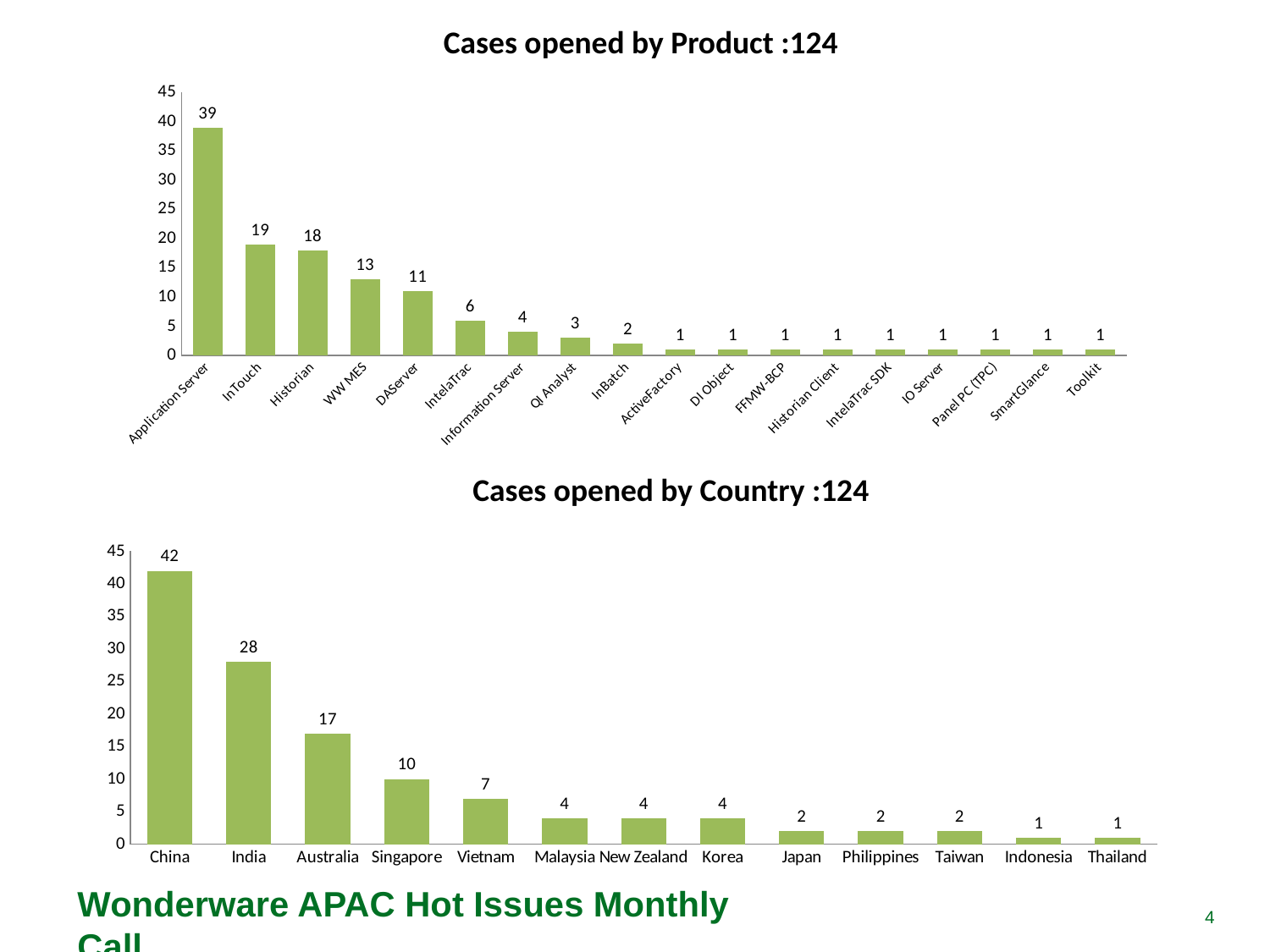
In the 'Cases opened by Country' chart, how many countries are shown? 13 What type of chart is the 'Cases opened by Country' chart? bar chart In the 'Cases opened by Product' chart, how many product categories are shown? 18 What is the title of the top chart on the slide? Cases opened by Product :124 In the 'Cases opened by Product' chart, which has more cases, WW MES or DAServer? WW MES In the 'Cases opened by Product' chart, what is the difference between the cases for Application Server and Historian? 21 In the 'Cases opened by Country' chart, do the values rise or fall from left to right along the x axis? fall In the 'Cases opened by Country' chart, what is the difference between the cases for China and India? 14 In the 'Cases opened by Country' chart, how many cases were opened for Singapore? 10 In the 'Cases opened by Product' chart, which product has the highest number of cases? Application Server In the 'Cases opened by Product' chart, how many cases were opened for InTouch? 19 In the 'Cases opened by Country' chart, which country has the highest number of cases? China